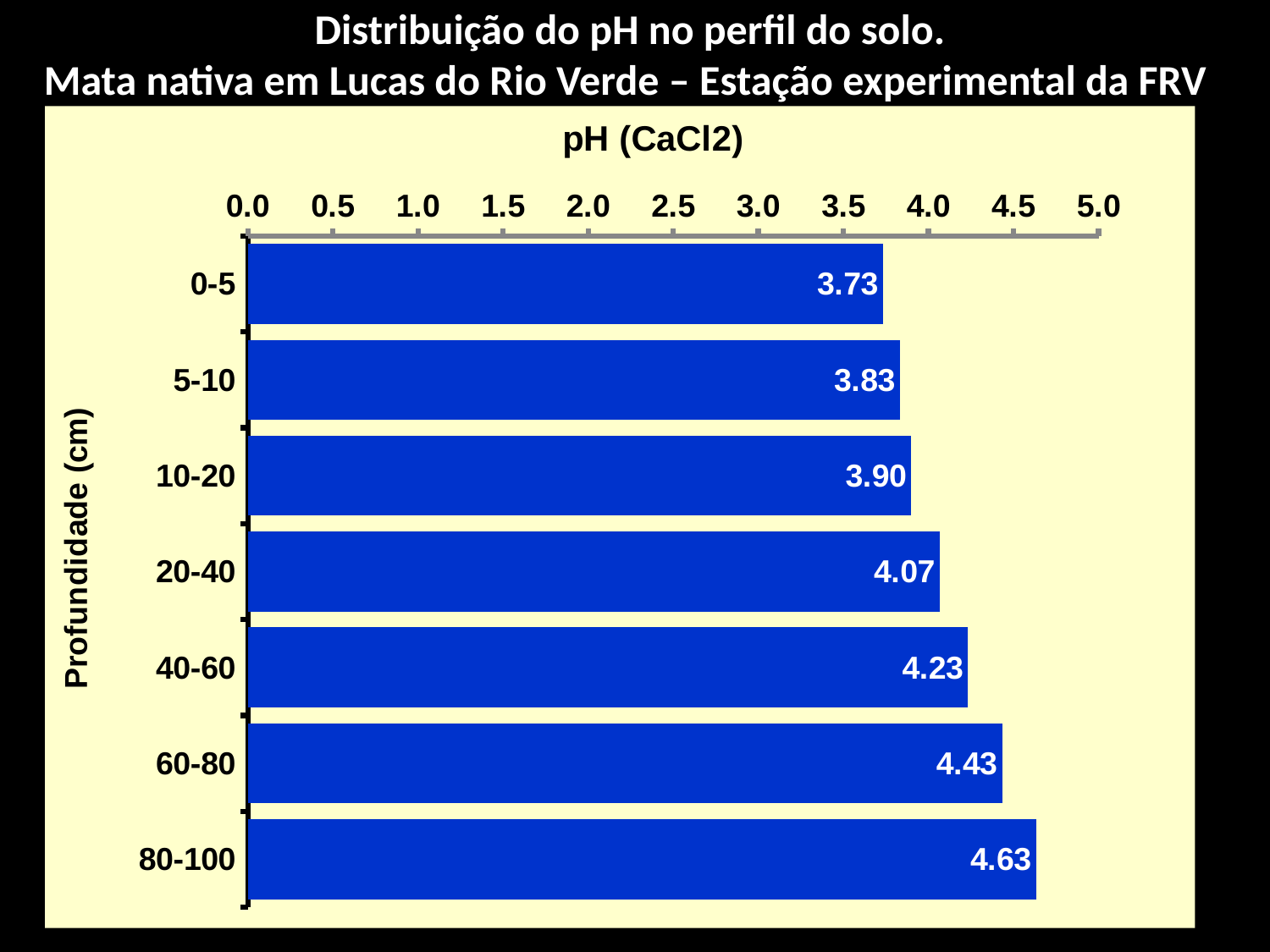
What kind of chart is shown on the slide? Bar chart Is the pH value for the 40-60 cm depth greater or less than 4.0? greater Which depth range has the lowest pH value? 0-5 What is the pH (CaCl2) value for the 0-5 cm depth? 3.73 What is the label of the vertical axis? Profundidade (cm) What is the pH (CaCl2) value for the 80-100 cm depth? 4.63 How many depth ranges are shown in the chart? 7 Which has a higher pH value, the 5-10 cm depth or the 10-20 cm depth? 10-20 What is the difference between the pH values for 60-80 cm and 40-60 cm? 0.20 What is the pH (CaCl2) value for the 20-40 cm depth? 4.07 Which depth range has the highest pH value? 80-100 What is the difference between the pH values for 80-100 cm and 0-5 cm? 0.90